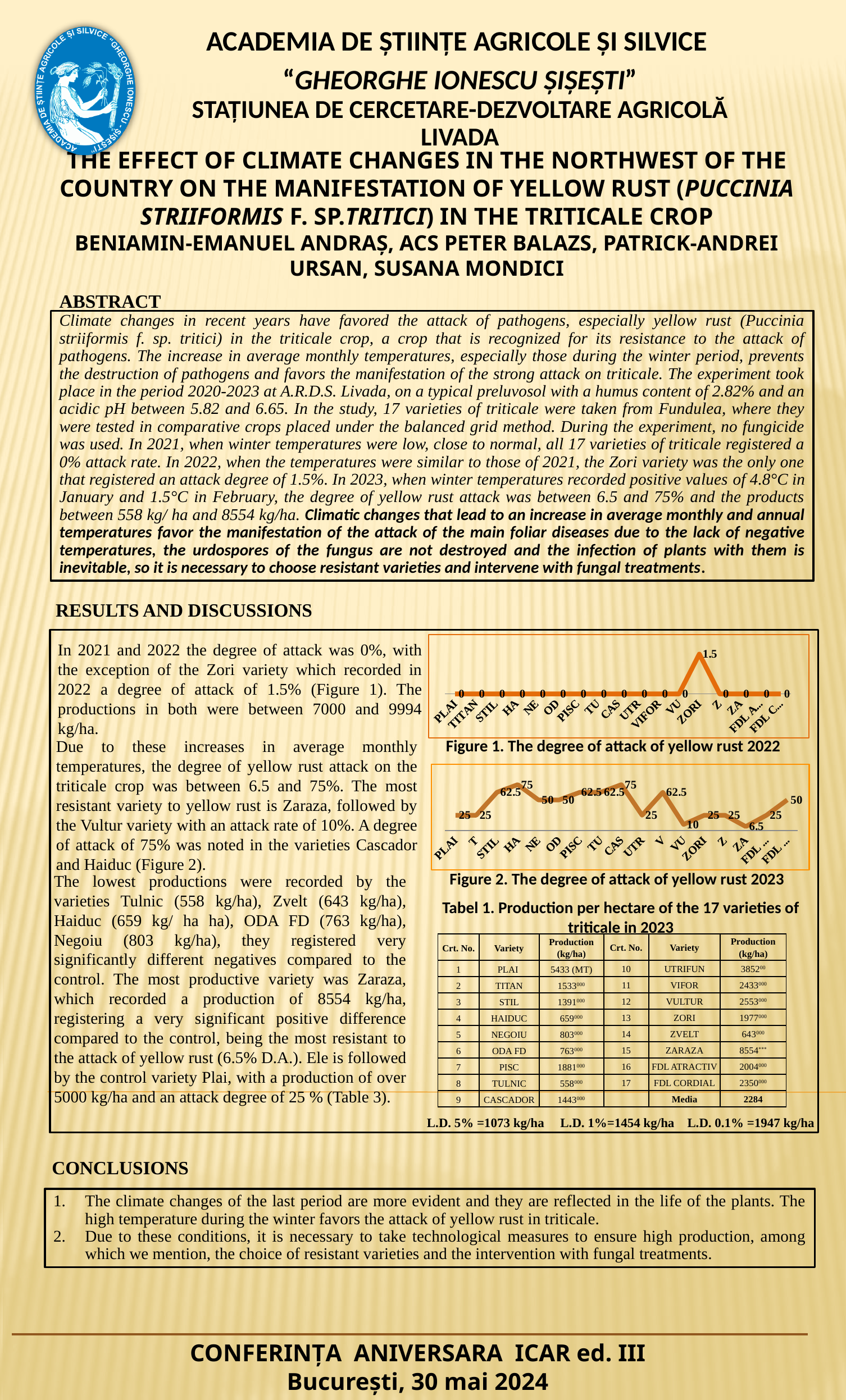
In Figure 2. The degree of attack of yellow rust 2023, what is the value for VU? 10 In Figure 2. The degree of attack of yellow rust 2023, what is the difference between the values for HA and ZA? 68.5 In Figure 1. The degree of attack of yellow rust 2022, what is the value for ZORI? 1.5 In Figure 2. The degree of attack of yellow rust 2023, what is the value for PLAI? 25 In Figure 2. The degree of attack of yellow rust 2023, which category has the lowest value? ZA In Figure 2. The degree of attack of yellow rust 2023, which is larger, the value for STIL or the value for NE? STIL In Figure 1. The degree of attack of yellow rust 2022, which category has the highest value? ZORI What is the title of the lower chart on the slide? Figure 2. The degree of attack of yellow rust 2023 In Figure 2. The degree of attack of yellow rust 2023, what is the value for ZORI? 25 In Figure 1. The degree of attack of yellow rust 2022, what is the value for PLAI? 0 How many data points are plotted in Figure 1. The degree of attack of yellow rust 2022? 17 What kind of chart is Figure 1. The degree of attack of yellow rust 2022? line chart